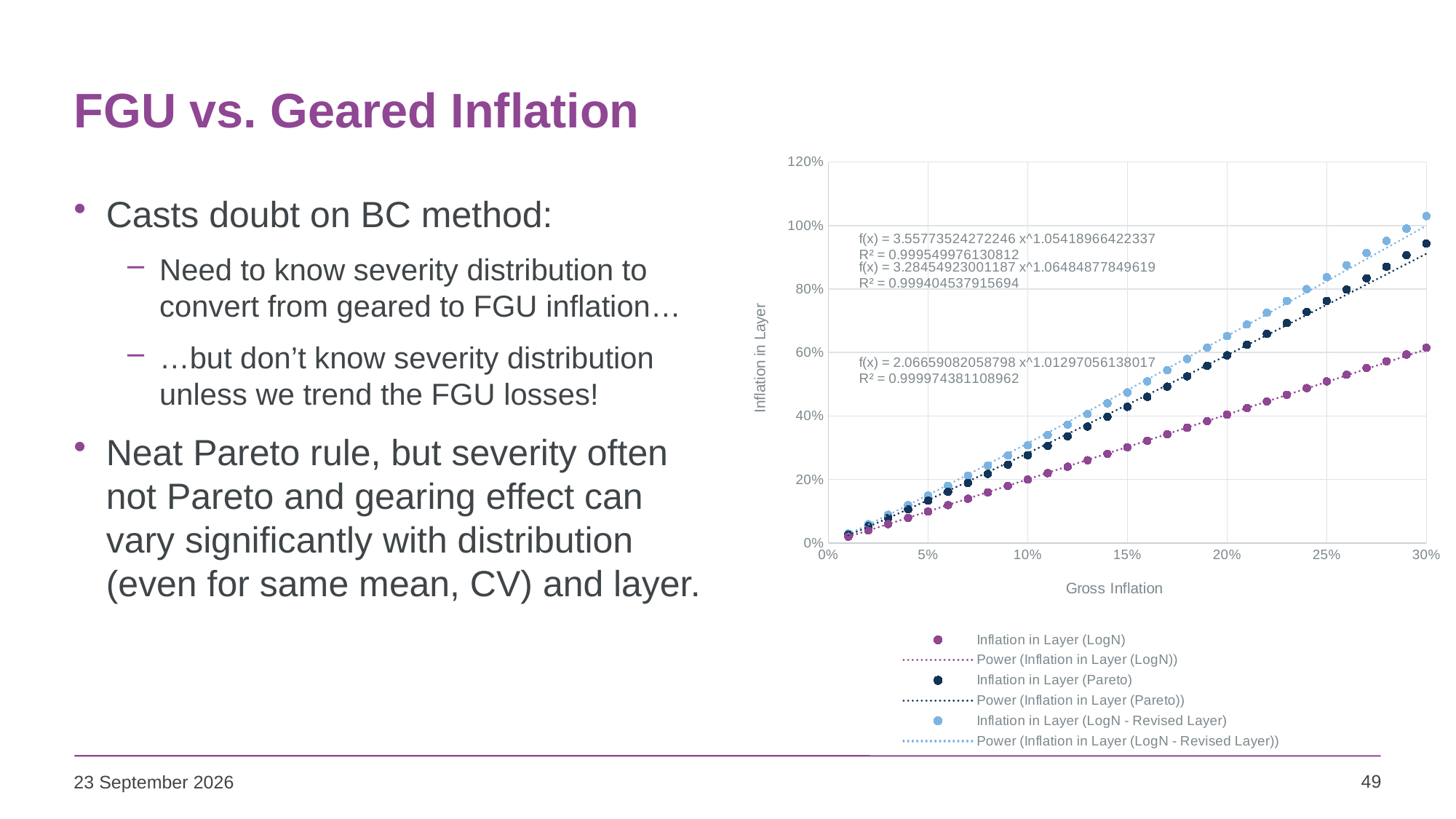
What is the title of the x axis of the chart? Gross Inflation How many entries does the chart legend list? 6 Do the values for Inflation in Layer (Pareto) rise or fall as Gross Inflation increases? rise Is the value for Inflation in Layer (LogN - Revised Layer) at 30% Gross Inflation greater or less than 100%? greater Which series reaches the highest Inflation in Layer at 30% Gross Inflation? Inflation in Layer (LogN - Revised Layer) Which series has the lowest Inflation in Layer at 30% Gross Inflation? Inflation in Layer (LogN) What is the title of the y axis of the chart? Inflation in Layer What kind of chart is shown on the slide? scatter chart Is the value for Inflation in Layer (LogN) at 30% Gross Inflation greater or less than 80%? less What R² value is printed for the trendline equation f(x) = 2.06659082058798 x^1.01297056138017? 0.999974381108962 At 30% Gross Inflation, which is larger: Inflation in Layer (Pareto) or Inflation in Layer (LogN)? Inflation in Layer (Pareto) Is the value for Inflation in Layer (Pareto) at 20% Gross Inflation greater or less than 40%? greater